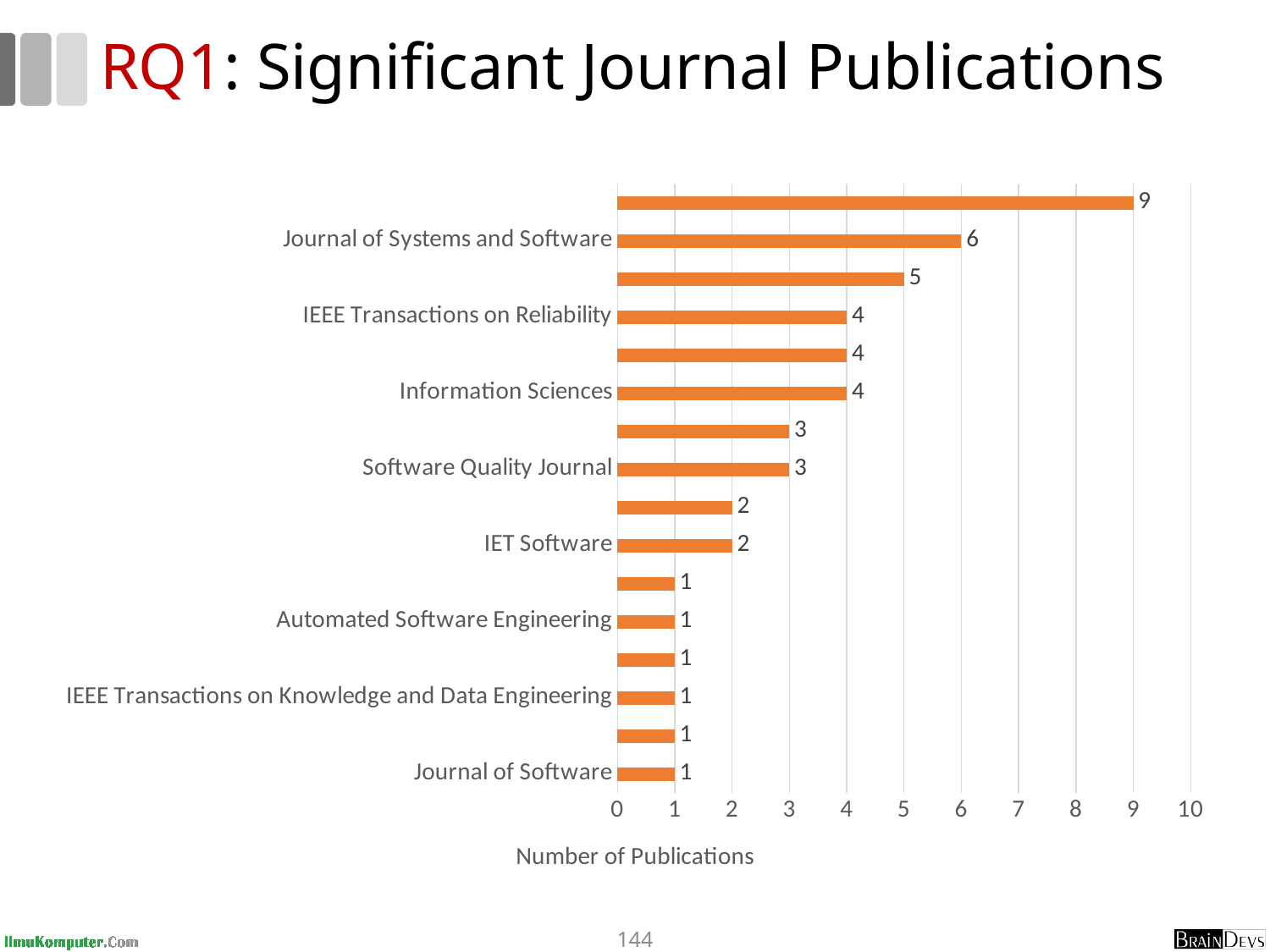
Is the value for Journal of Systems and Software greater or less than 5? greater How many publications does the chart show for Journal of Systems and Software? 6 What value is shown for IET Software? 2 What is the value for IEEE Transactions on Reliability? 4 What is the number of publications for Software Quality Journal? 3 What is the value for Automated Software Engineering? 1 How many publications are shown for Journal of Software? 1 Which has more publications, Information Sciences or IET Software? Information Sciences How many bars are plotted in the chart? 16 What is the difference between the values for Journal of Systems and Software and Software Quality Journal? 3 What kind of chart is shown on the slide? bar chart What is the largest value shown on any bar in the chart? 9